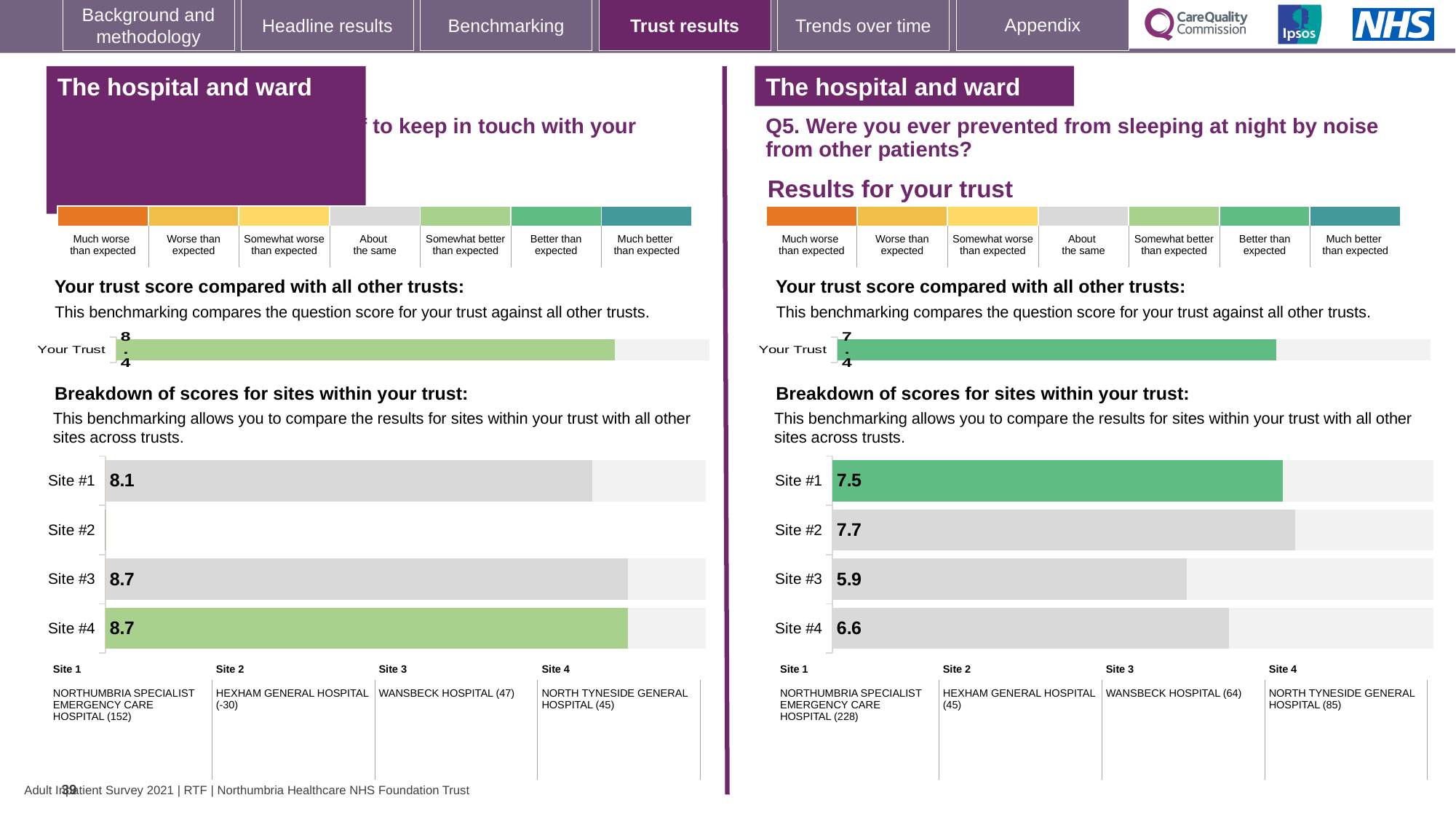
On the right-hand Q5 site breakdown chart, what is the score for Site #4? 6.6 On the right-hand Q5 'Your trust score compared with all other trusts' chart, what is the score for Your Trust? 7.4 On the left-hand site breakdown chart, how many sites have a score value displayed? 3 On the left-hand 'Your trust score compared with all other trusts' chart, what is the score for Your Trust? 8.4 On the right-hand Q5 site breakdown chart, what is the score for Site #3? 5.9 What type of chart is used for the site breakdown on the right-hand side of the slide? Bar chart On the left-hand site breakdown chart, what is the difference between the scores for Site #3 and Site #1? 0.6 On the right-hand Q5 site breakdown chart, which site has the lowest score? Site #3 On the right-hand Q5 site breakdown chart, which has the higher score, Site #1 or Site #4? Site #1 On the right-hand Q5 site breakdown chart, what is the difference between the scores for Site #2 and Site #3? 1.8 On the left-hand site breakdown chart, what is the score for Site #1? 8.1 On the right-hand Q5 site breakdown chart, which site has the highest score? Site #2